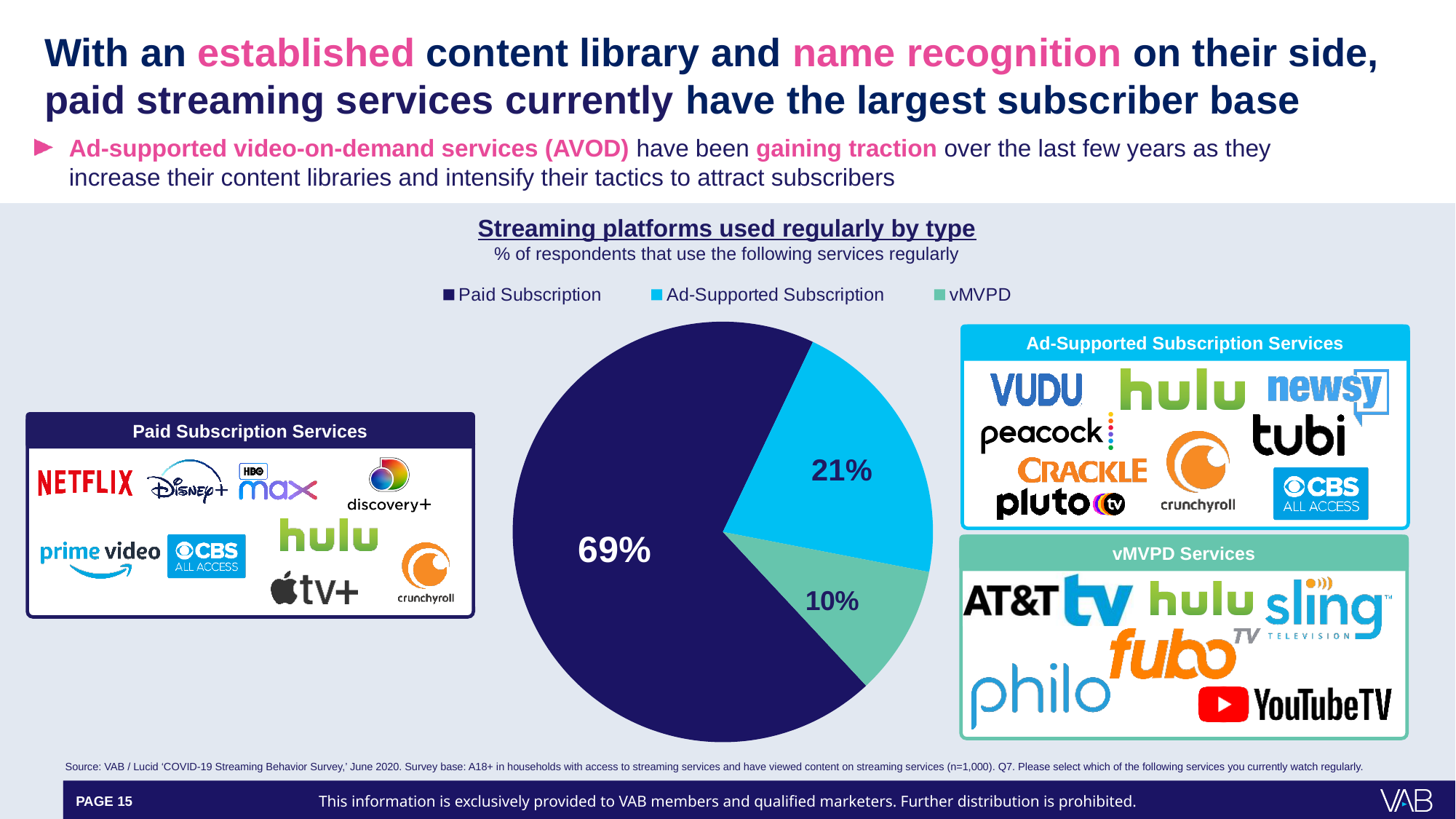
What is the difference in percentage points between Paid Subscription and Ad-Supported Subscription? 48 How many slices does the pie chart have? 3 What percentage of respondents regularly use Ad-Supported Subscription streaming platforms? 21% Which is larger, the share for Ad-Supported Subscription or the share for vMVPD? Ad-Supported Subscription Which streaming platform type has the largest share of the pie? Paid Subscription What kind of chart is shown on the slide? Pie chart What is the title of the chart? Streaming platforms used regularly by type What percentage of respondents regularly use Paid Subscription streaming platforms? 69% How many series does the legend list? 3 Which streaming platform type has the smallest share of the pie? vMVPD What percentage of respondents regularly use vMVPD streaming platforms? 10% What is the difference in percentage points between Ad-Supported Subscription and vMVPD? 11